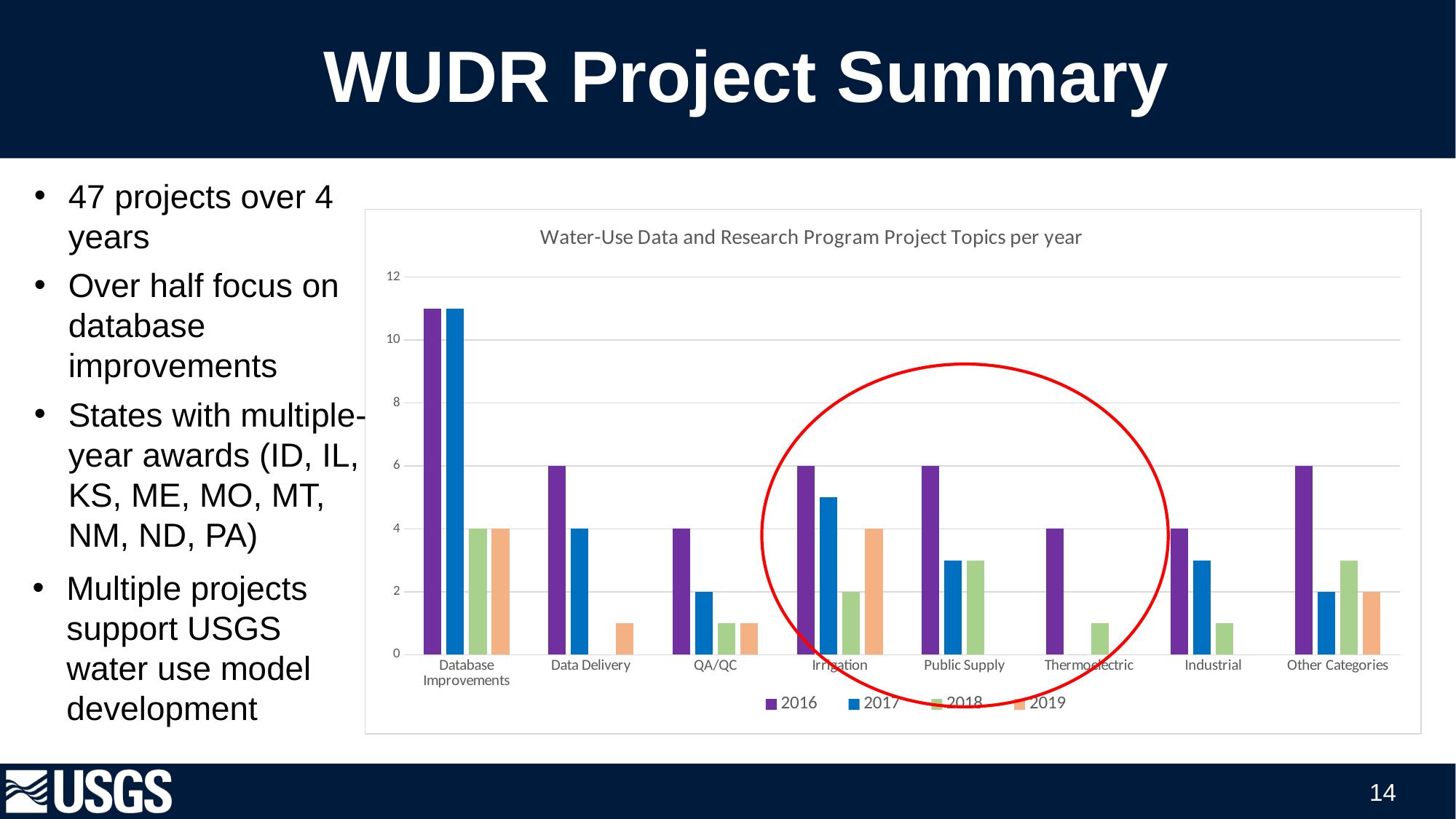
What kind of chart is shown on the slide? bar chart What is the title of the chart? Water-Use Data and Research Program Project Topics per year How many project topic categories are shown on the x axis? 8 What is the value for Irrigation in 2019? 4 Is the value for Database Improvements in 2016 greater or less than 10? greater Which category has the highest value for 2016? Database Improvements Which has the larger 2016 value, Irrigation or Thermoelectric? Irrigation Is the value for Public Supply in 2017 greater or less than 4? less What is the value for Data Delivery in 2016? 6 How many series does the chart legend list? 4 What is the difference between the 2016 and 2017 values for Data Delivery? 2 What is the value for QA/QC in 2017? 2